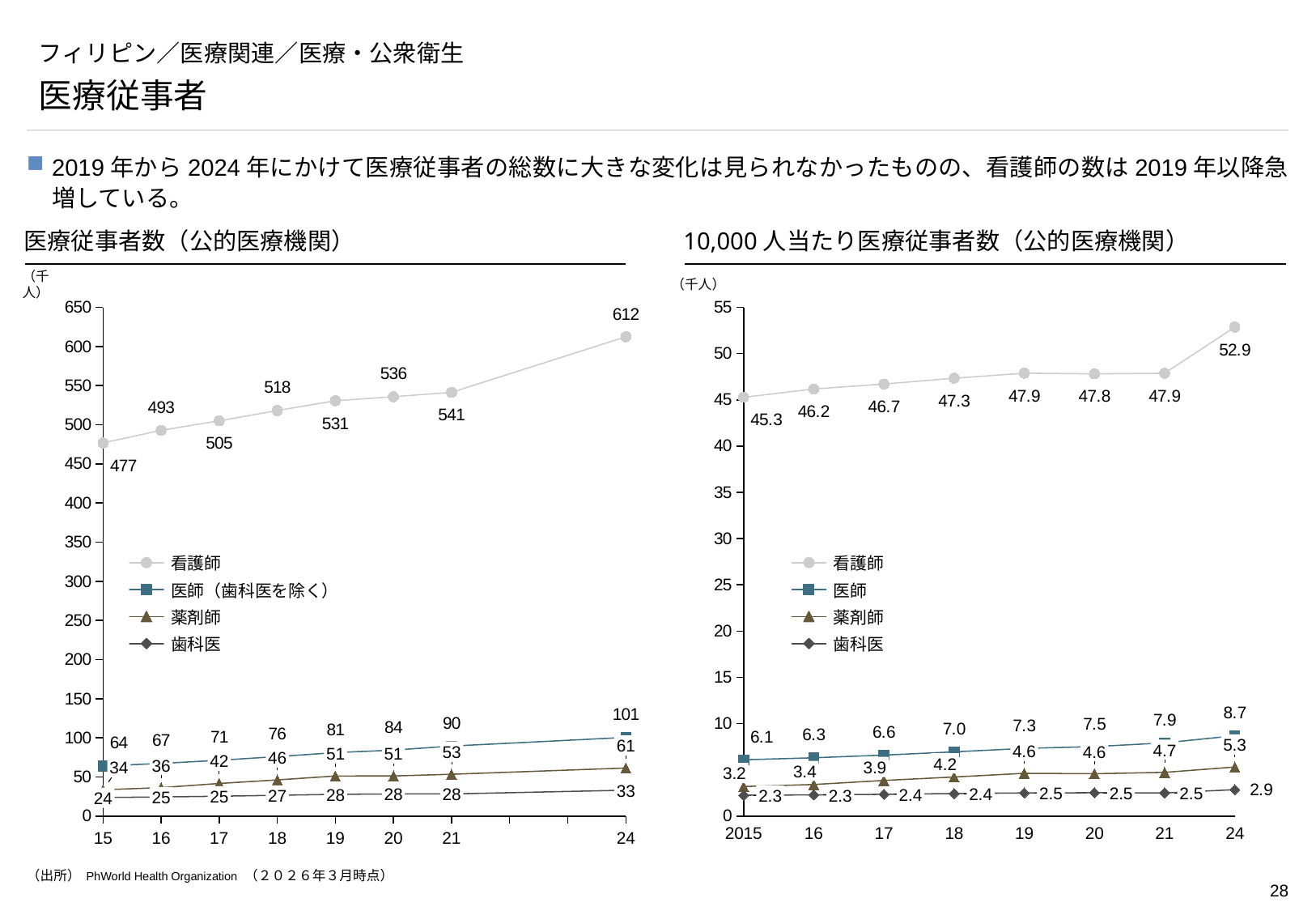
In the left chart 医療従事者数（公的医療機関）, how many series does the legend list? 4 In the right chart 10,000人当たり医療従事者数（公的医療機関）, what is the value for 看護師 in 2015? 45.3 In the right chart 10,000人当たり医療従事者数（公的医療機関）, does the 医師 series rise or fall from 2015 to 24? rise In the left chart 医療従事者数（公的医療機関）, what is the value for 医師（歯科医を除く） in 19? 81 In the left chart 医療従事者数（公的医療機関）, what is the value for 看護師 in 24? 612 In the right chart 10,000人当たり医療従事者数（公的医療機関）, is the value for 看護師 in 24 greater or less than 50? greater What kind of chart is the left chart 医療従事者数（公的医療機関）? line chart In the left chart 医療従事者数（公的医療機関）, which series has the lowest value in 24? 歯科医 In the left chart 医療従事者数（公的医療機関）, by how much did 看護師 increase from 21 to 24? 71 In the left chart 医療従事者数（公的医療機関）, what is the value for 歯科医 in 15? 24 In the right chart 10,000人当たり医療従事者数（公的医療機関）, what is the value for 薬剤師 in 24? 5.3 In the right chart 10,000人当たり医療従事者数（公的医療機関）, what is the difference between 医師 and 歯科医 in 24? 5.8